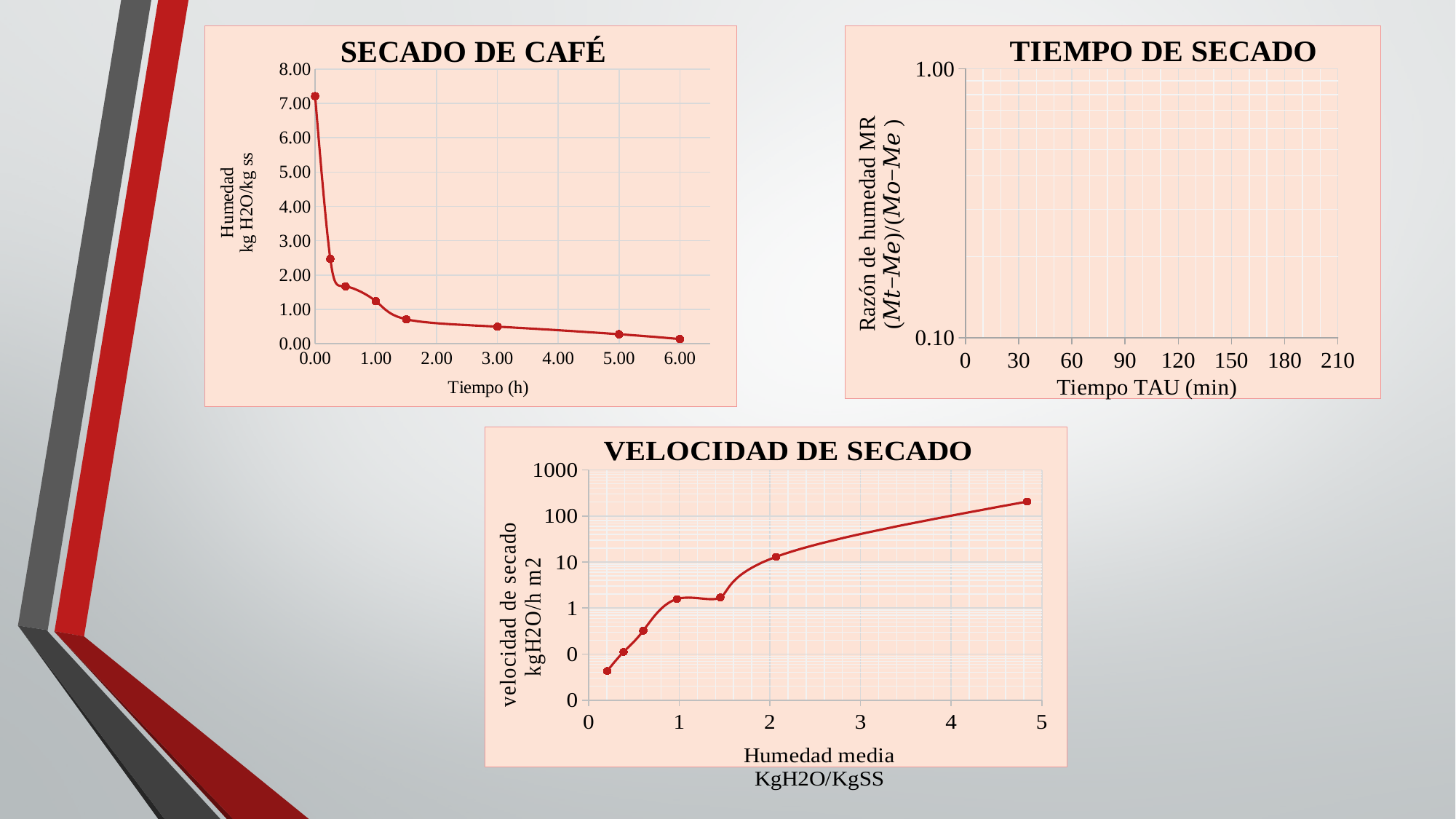
In the VELOCIDAD DE SECADO chart, do the values rise or fall as Humedad media increases? rise What kind of chart is the SECADO DE CAFÉ chart? line chart In the SECADO DE CAFÉ chart, at which Tiempo (h) is the Humedad highest? 0.00 In the SECADO DE CAFÉ chart, is the Humedad at Tiempo 0.00 greater or less than 7.00? greater In the VELOCIDAD DE SECADO chart, how many data points are plotted? 7 In the SECADO DE CAFÉ chart, which has the larger Humedad: Tiempo 1.00 or Tiempo 5.00? Tiempo 1.00 In the SECADO DE CAFÉ chart, how many data points are plotted? 8 In the SECADO DE CAFÉ chart, is the Humedad at Tiempo 3.00 greater or less than 1.00? less In the SECADO DE CAFÉ chart, at which Tiempo (h) is the Humedad lowest? 6.00 In the SECADO DE CAFÉ chart, do the values rise or fall as Tiempo (h) increases? fall What is the x-axis title of the TIEMPO DE SECADO chart? Tiempo TAU (min) In the VELOCIDAD DE SECADO chart, is the value of the rightmost point (near Humedad media 5) greater or less than 100? greater